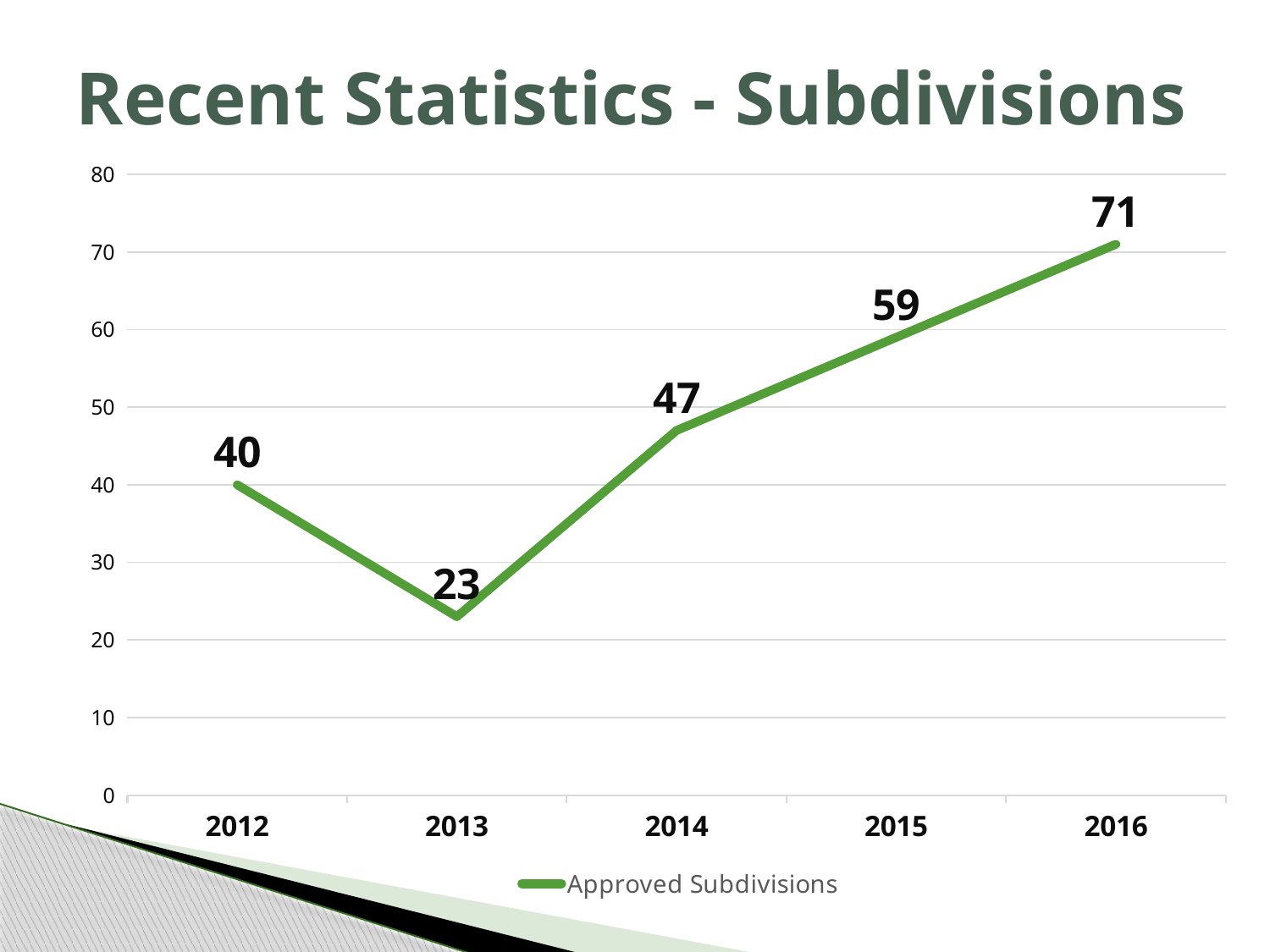
What is the difference between the Approved Subdivisions values for 2016 and 2015? 12 How many series does the legend list? 1 How many years are plotted on the chart? 5 What is the difference between the Approved Subdivisions values for 2014 and 2013? 24 Do the Approved Subdivisions values rise or fall from 2013 to 2016? Rise Which year has the lowest number of Approved Subdivisions? 2013 What is the value of Approved Subdivisions in 2016? 71 What kind of chart is shown on the slide? Line chart What is the value of Approved Subdivisions in 2013? 23 What is the value of Approved Subdivisions in 2012? 40 Which year has the highest number of Approved Subdivisions? 2016 Which year has more Approved Subdivisions, 2012 or 2014? 2014